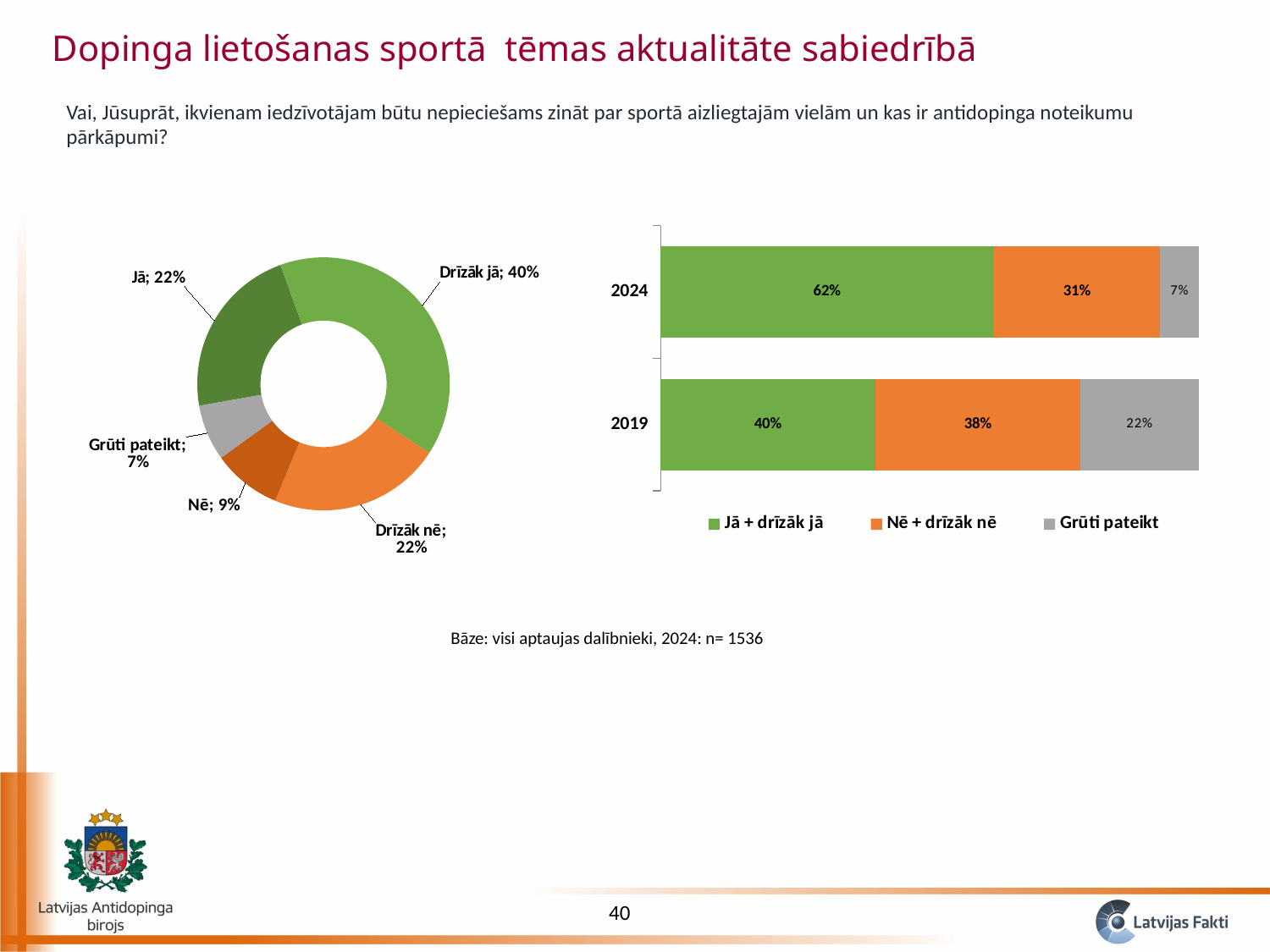
In the doughnut chart on the left, which category has the largest share? Drīzāk jā In the doughnut chart on the left, how many categories are shown? 5 In the doughnut chart on the left, what share is labelled "Drīzāk jā"? 40% What kind of chart is the chart on the right of the slide? Stacked bar chart In the stacked bar chart on the right, what is the difference between the "Jā + drīzāk jā" values for 2024 and 2019? 22 percentage points In the stacked bar chart on the right, what is the value of "Jā + drīzāk jā" for 2024? 62% In the doughnut chart on the left, which category has the smallest share? Grūti pateikt What kind of chart is the chart on the left of the slide? Doughnut chart In the stacked bar chart on the right, which year has the larger "Nē + drīzāk nē" value, 2024 or 2019? 2019 In the doughnut chart on the left, what share is labelled "Nē"? 9% How many series does the legend of the stacked bar chart on the right list? 3 In the stacked bar chart on the right, what is the value of "Grūti pateikt" for 2019? 22%